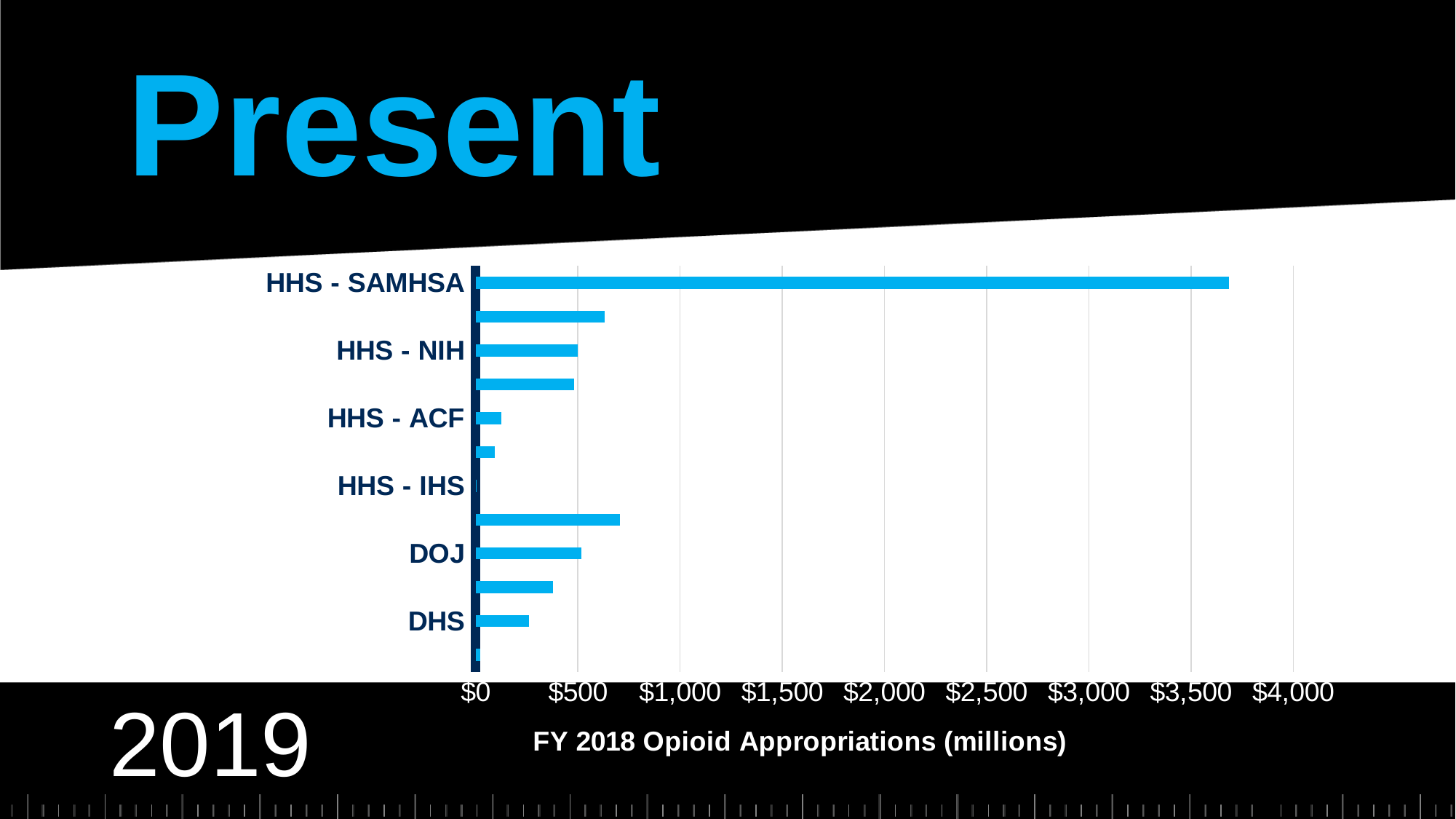
Which is larger, the value for HHS - NIH or the value for HHS - ACF? HHS - NIH What kind of chart is shown on the slide? bar chart Which labeled category has the lowest FY 2018 opioid appropriation? HHS - IHS Which is larger, the value for DHS or the value for HHS - ACF? DHS Is the value for HHS - ACF greater or less than $500? less Is the value for DOJ greater or less than $1,000? less Which labeled category has the highest FY 2018 opioid appropriation? HHS - SAMHSA What is the title of the horizontal axis of the chart? FY 2018 Opioid Appropriations (millions) How many category labels are shown on the vertical axis of the chart? 6 Is the value for DHS greater or less than $500? less Which is larger, the value for HHS - SAMHSA or the value for DOJ? HHS - SAMHSA